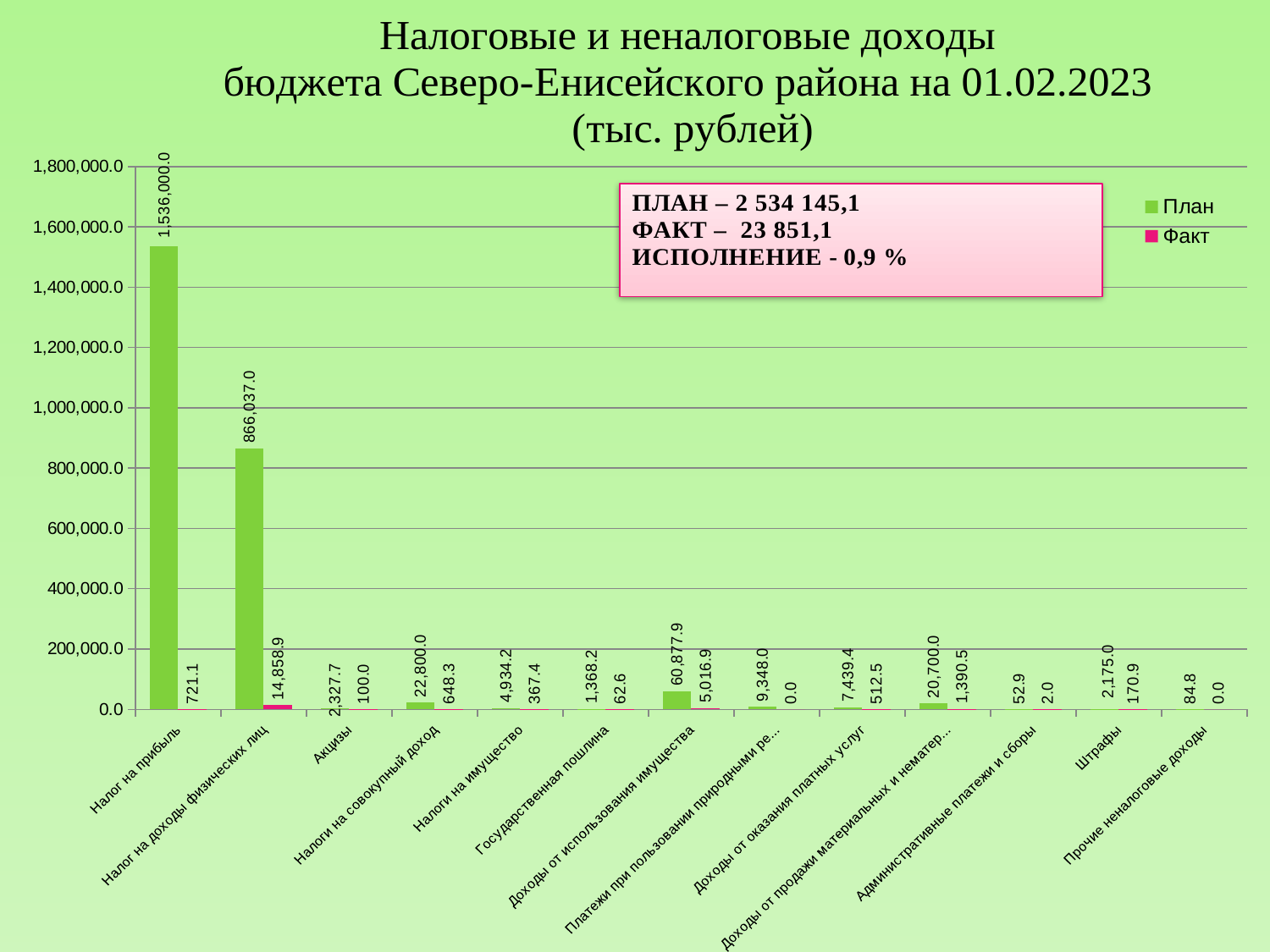
What is the difference between the План and Факт values for Налог на прибыль? 1,535,278.9 Which is larger: the Факт value for Акцизы or the Факт value for Налоги на имущество? Налоги на имущество What kind of chart is shown on the slide? Bar chart How many series does the legend list? 2 Which category has the lowest План value? Административные платежи и сборы What colour are the Факт bars? Pink How many categories are shown on the x axis? 13 What is the План value for Доходы от использования имущества? 60,877.9 What is the План value for Налог на прибыль? 1,536,000.0 What is the Факт value for Штрафы? 170.9 Which category has the highest План value? Налог на прибыль What is the Факт value for Налог на доходы физических лиц? 14,858.9